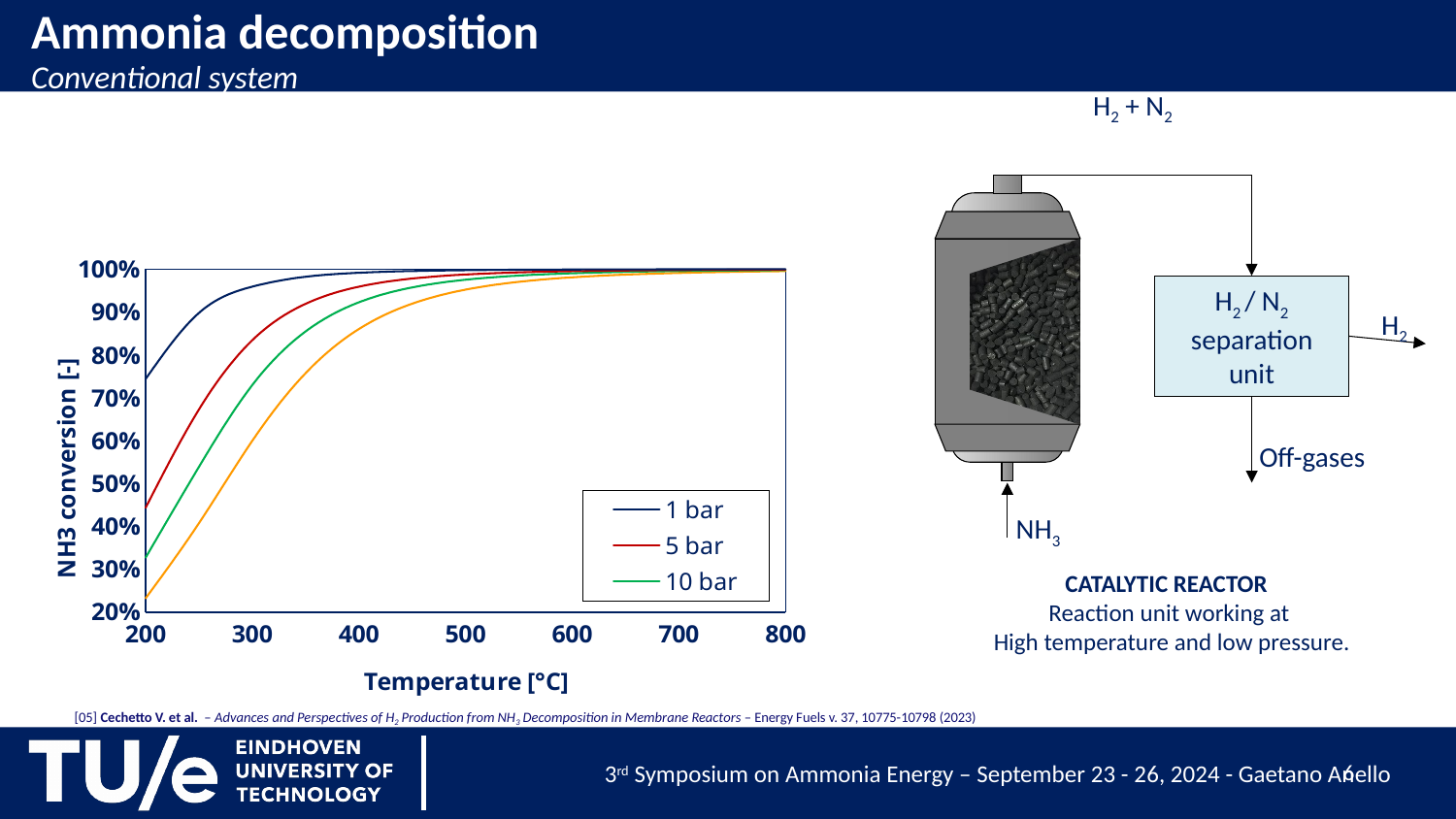
Is the NH3 conversion for 1 bar at 200 °C greater or less than 70%? greater How many series does the chart legend list? 3 Is the NH3 conversion for 1 bar at 400 °C greater or less than 90%? greater What kind of chart is shown on the slide? line chart Is the NH3 conversion for 10 bar at 200 °C greater or less than 40%? less Which series has the highest NH3 conversion at 200 °C? 1 bar Which series are listed in the chart legend? 1 bar, 5 bar, 10 bar At 300 °C, which has the higher NH3 conversion, 1 bar or 5 bar? 1 bar Does NH3 conversion rise or fall as temperature increases along the x axis? rise At 300 °C, which has the lower NH3 conversion, 5 bar or 10 bar? 10 bar What is the title of the x axis of the chart? Temperature [°C]